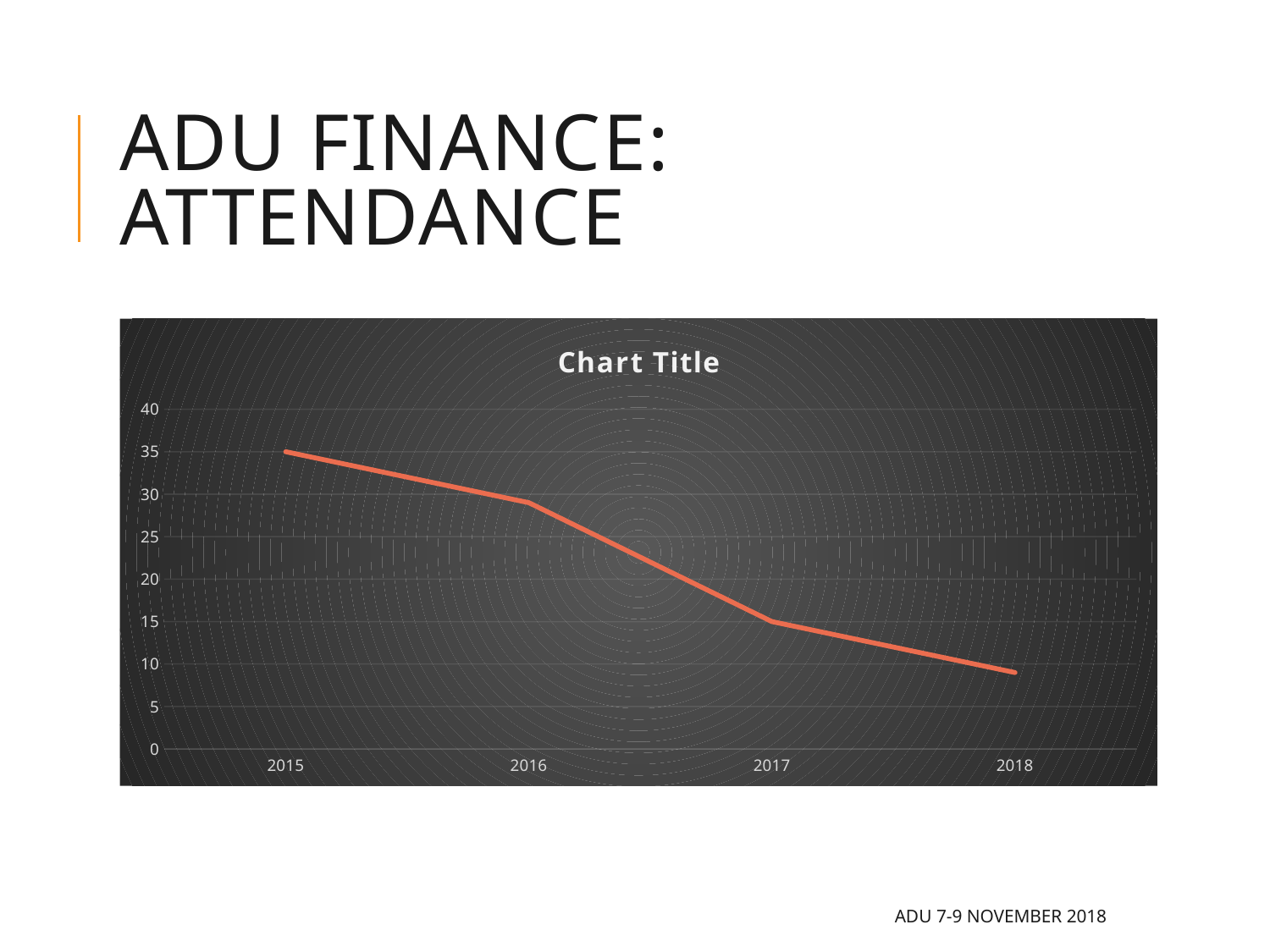
Is the value for 2017 greater or less than 20? less Do the values rise or fall from 2015 to 2018? fall Which year has the larger value, 2016 or 2017? 2016 What kind of chart is shown on the slide? line chart Which year has the lowest value on the chart? 2018 How many years are plotted on the x axis of the chart? 4 Which year has the highest value on the chart? 2015 Is the value for 2015 greater or less than 30? greater What is the title shown on the chart? Chart Title Is the value for 2016 greater or less than 25? greater What is the first year shown on the x axis of the chart? 2015